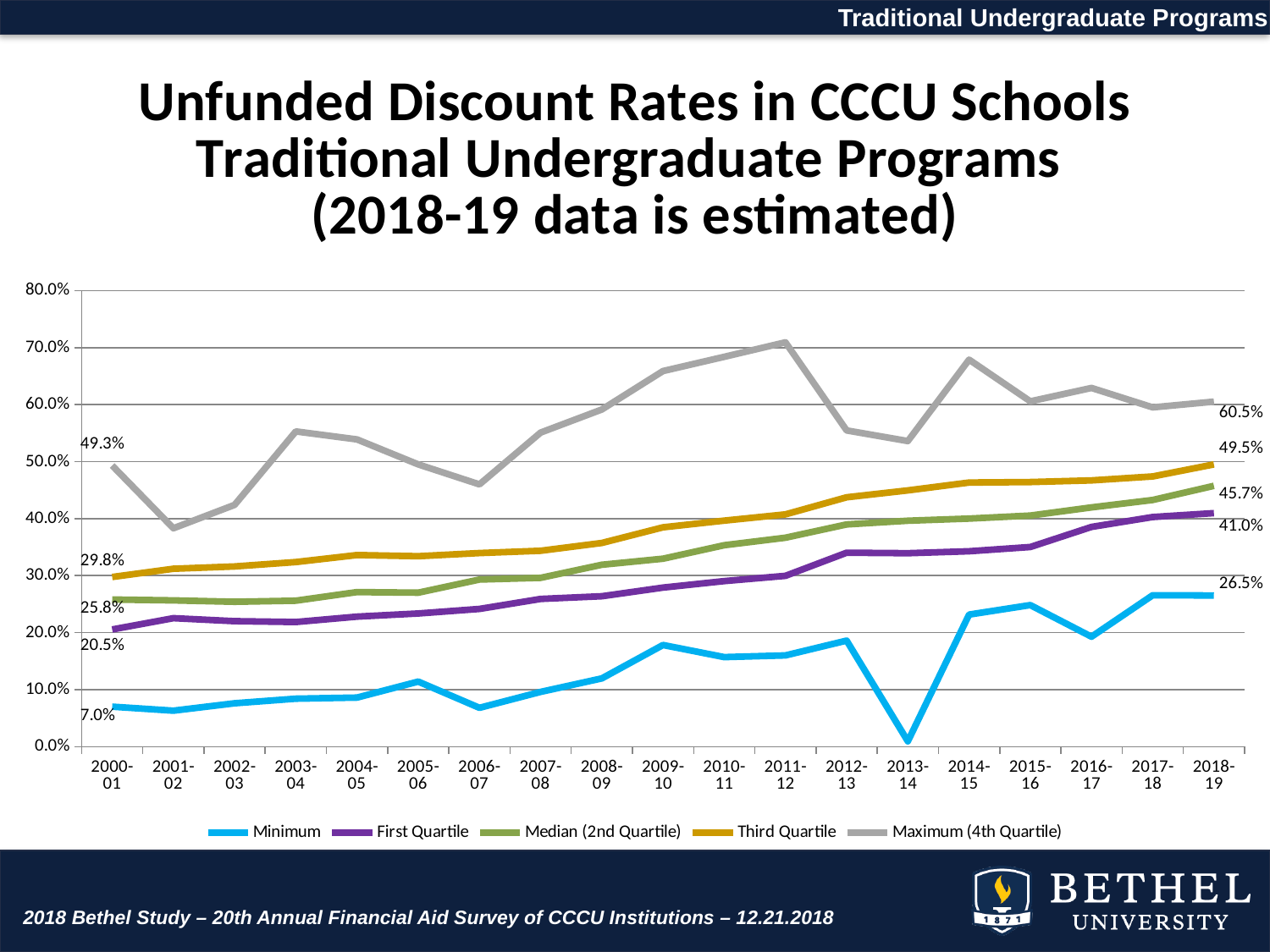
Does the First Quartile series generally rise or fall from 2000-01 to 2018-19? rise What type of chart is shown on the slide? line chart What is the First Quartile value for 2000-01? 20.5% Is the Maximum (4th Quartile) value for 2011-12 greater or less than 70.0%? greater What is the Median (2nd Quartile) value for 2018-19? 45.7% What is the Maximum (4th Quartile) value for 2000-01? 49.3% How many academic years are plotted along the x axis? 19 How many series does the legend list? 5 What is the difference between the Third Quartile value in 2018-19 and in 2000-01? 19.7% Which is larger, the Minimum value in 2000-01 or the Minimum value in 2018-19? 2018-19 Which series has the highest value in 2018-19? Maximum (4th Quartile) What is the Minimum value for 2018-19? 26.5%